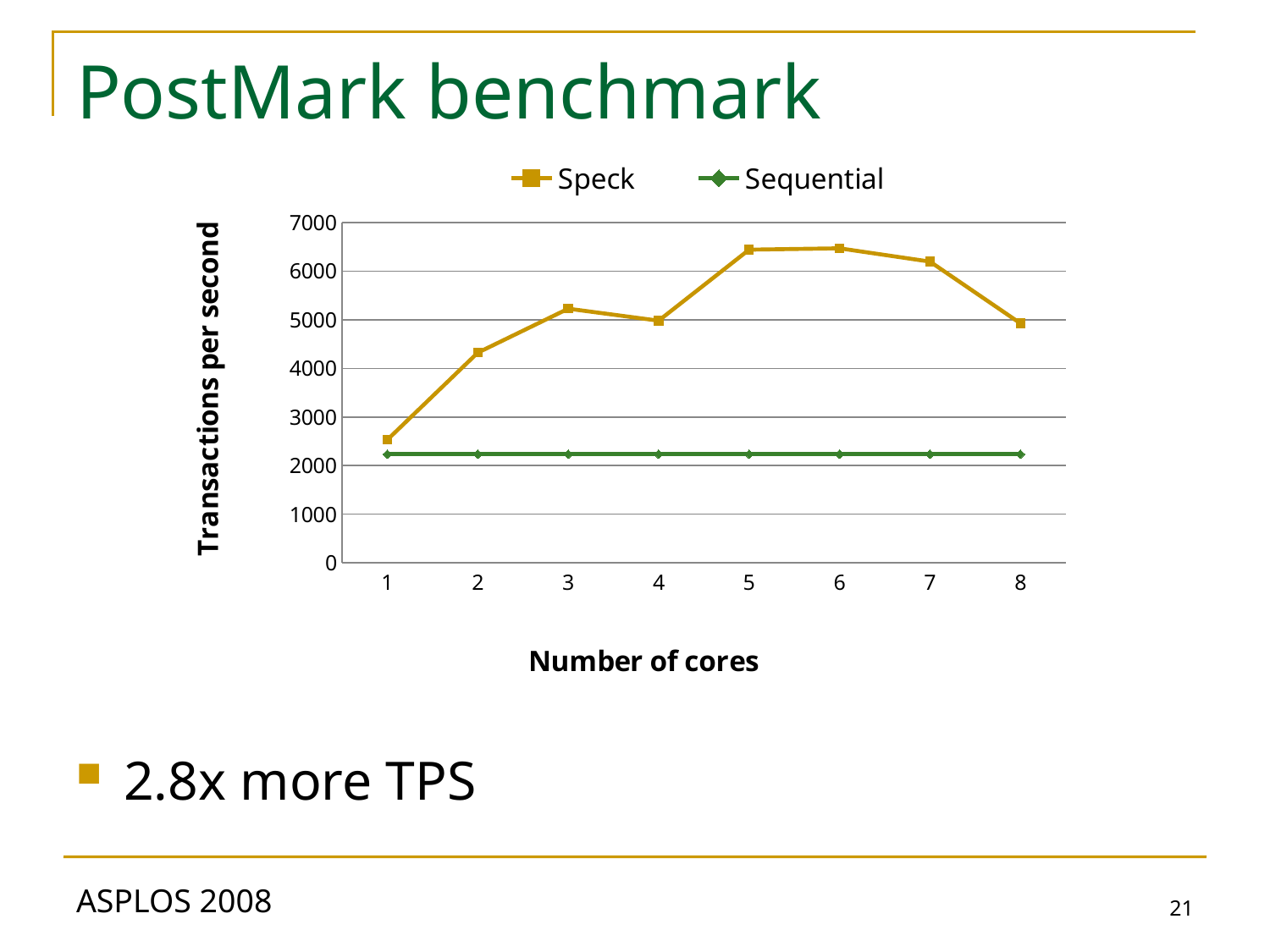
How many series does the legend list? 2 Is the Speck value at 5 cores greater or less than 6000 transactions per second? greater For the Speck series, is the value at 7 cores or at 8 cores larger? 7 cores What is the label of the y axis? Transactions per second Is the Sequential value at 4 cores greater or less than 3000 transactions per second? less Is the Speck value at 2 cores greater or less than 4000 transactions per second? greater Does the Speck series rise or fall from 1 core to 3 cores? rise At which number of cores is the Speck series lowest? 1 What kind of chart is shown on the slide? line chart How many core counts are plotted along the x axis? 8 At 8 cores, which series has the higher transactions per second, Speck or Sequential? Speck